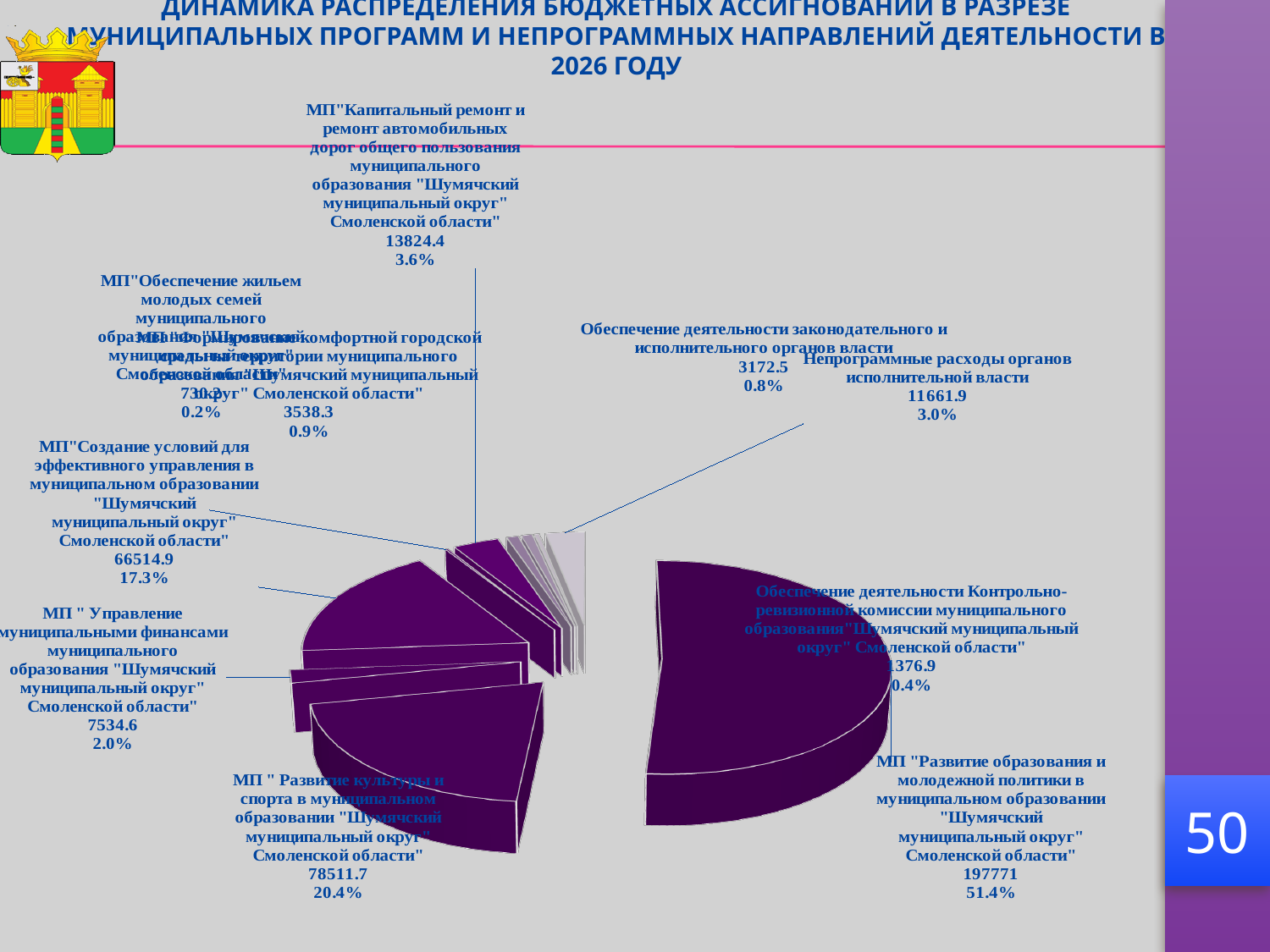
What is the difference between the values for МП "Развитие культуры и спорта" (78511.7) and МП "Создание условий для эффективного управления" (66514.9)? 11996.8 What is the value shown for Непрограммные расходы органов исполнительной власти? 11661.9 Which year does the chart title say the budget allocation distribution refers to? 2026 What share of the pie does Обеспечение деятельности Контрольно-ревизионной комиссии have? 0.4% What kind of chart is shown on the slide? Pie chart What share of the pie does МП "Создание условий для эффективного управления" have? 17.3% What share of the pie does МП "Развитие образования и молодежной политики" have? 51.4% How many categories (slices) does the pie chart show? 10 Which is larger: the value for МП "Капитальный ремонт и ремонт автомобильных дорог" or for Непрограммные расходы органов исполнительной власти? МП "Капитальный ремонт и ремонт автомобильных дорог" What is the value shown for МП "Развитие образования и молодежной политики"? 197771 Which category has the largest share of the pie? МП "Развитие образования и молодежной политики в муниципальном образовании "Шумячский муниципальный округ" Смоленской области" What is the value shown for МП "Развитие культуры и спорта"? 78511.7